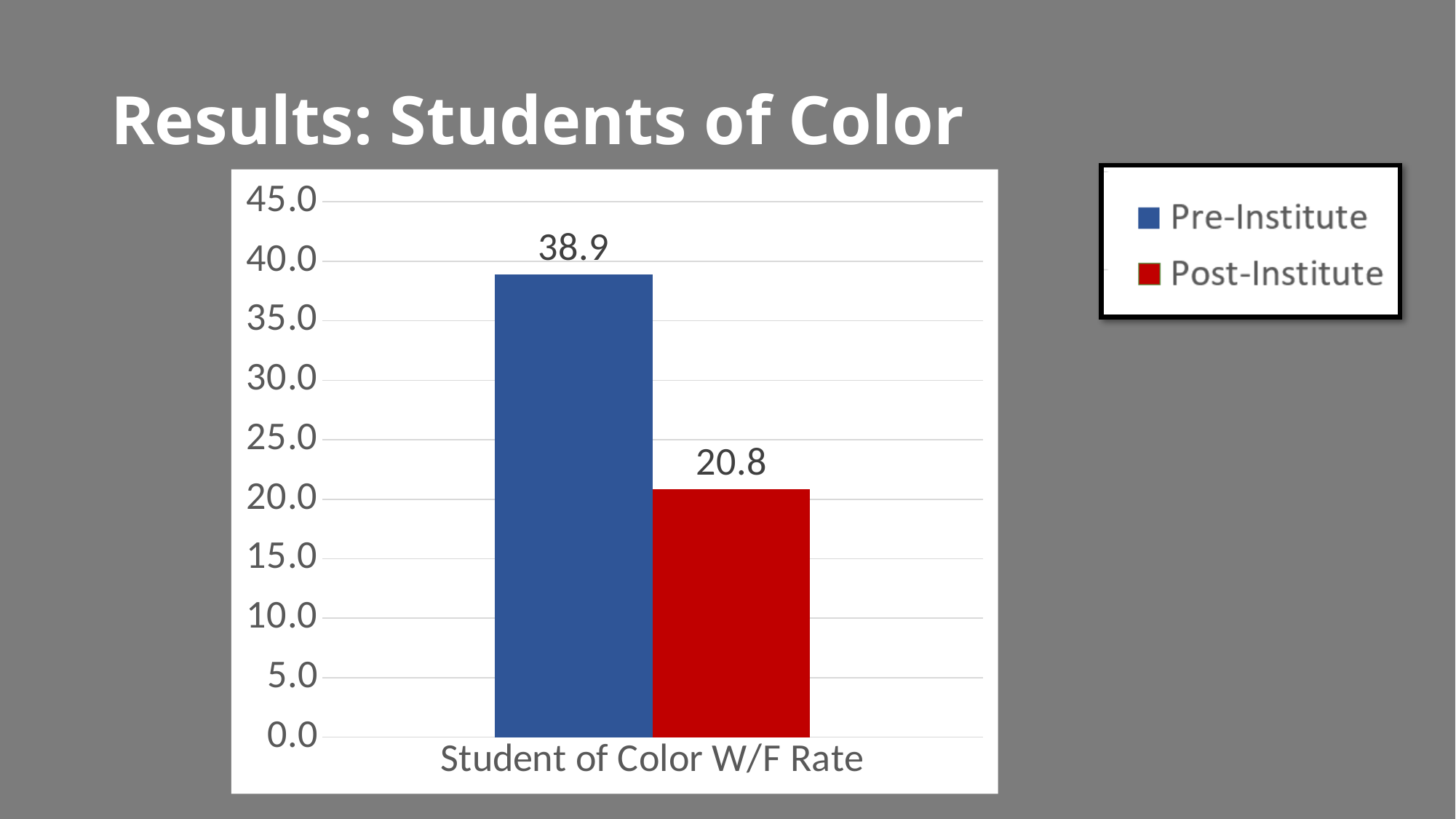
What kind of chart is shown on the slide? Bar chart Is the Post-Institute value greater or less than 25.0? less Which series has the lowest value on the chart? Post-Institute What colour is the Post-Institute bar? Red Is the Pre-Institute value greater or less than 35.0? greater Which series has the higher value for Student of Color W/F Rate, Pre-Institute or Post-Institute? Pre-Institute How many categories are shown on the x axis? 1 How many series does the legend list? 2 What is the difference between the Pre-Institute and Post-Institute values for Student of Color W/F Rate? 18.1 What is the label of the category on the x axis? Student of Color W/F Rate What is the Pre-Institute value for Student of Color W/F Rate? 38.9 What is the Post-Institute value for Student of Color W/F Rate? 20.8